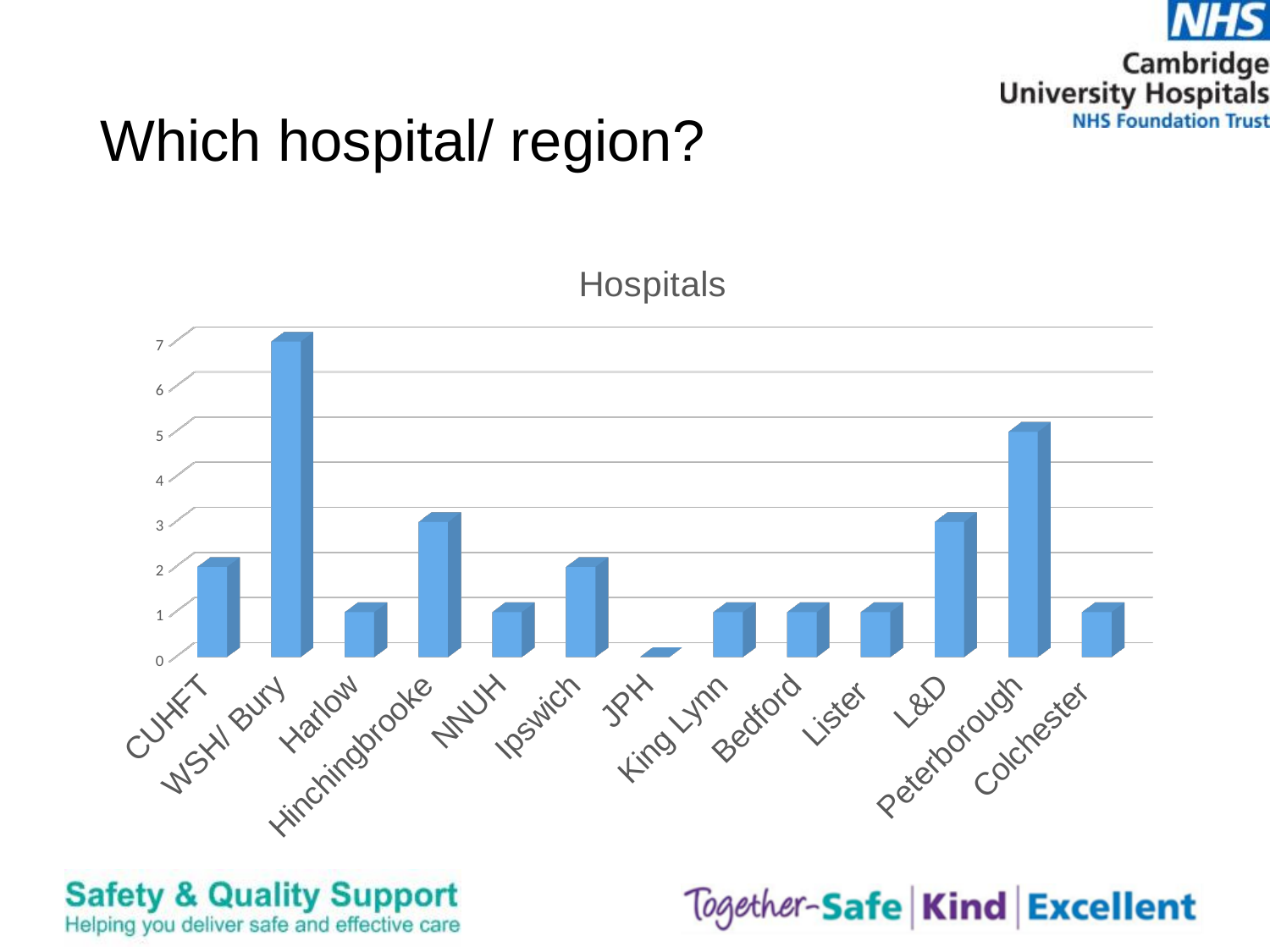
Which has a larger value, Hinchingbrooke or Ipswich? Hinchingbrooke What is the title of the chart? Hospitals What is the value for WSH/ Bury? 7 Which hospital has the lowest value in the chart? JPH What is the value for Peterborough? 5 Is the value for Peterborough greater or less than 4? greater Which hospital has the highest value in the chart? WSH/ Bury What is the difference between the values for WSH/ Bury and Peterborough? 2 What kind of chart is shown on the slide? bar chart How many hospitals are shown on the x axis of the chart? 13 What is the value for Hinchingbrooke? 3 What is the value for CUHFT? 2